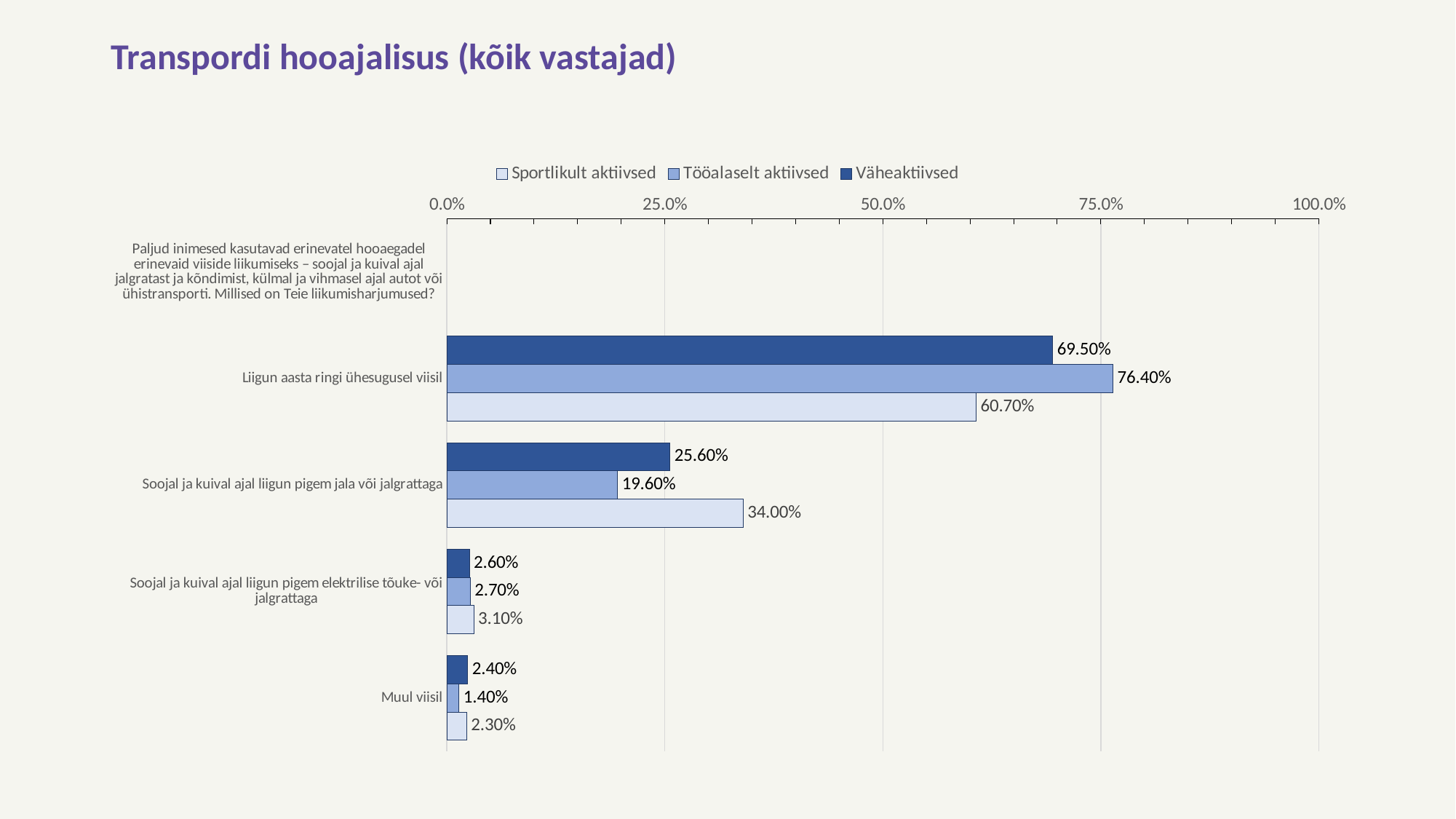
What is the difference between the Tööalaselt aktiivsed and Sportlikult aktiivsed values in the category "Liigun aasta ringi ühesugusel viisil"? 15.70% Is the Väheaktiivsed value for "Liigun aasta ringi ühesugusel viisil" greater or less than 50.0%? greater What is the value for Sportlikult aktiivsed in the category "Soojal ja kuival ajal liigun pigem jala või jalgrattaga"? 34.00% Which series has the lowest value in the category "Soojal ja kuival ajal liigun pigem jala või jalgrattaga"? Tööalaselt aktiivsed What kind of chart is shown on the slide? bar chart What is the title of the slide? Transpordi hooajalisus (kõik vastajad) What is the value for Tööalaselt aktiivsed in the category "Soojal ja kuival ajal liigun pigem elektrilise tõuke- või jalgrattaga"? 2.70% Which series has the highest value in the category "Liigun aasta ringi ühesugusel viisil"? Tööalaselt aktiivsed What is the value for Väheaktiivsed in the category "Muul viisil"? 2.40% What is the value for Tööalaselt aktiivsed in the category "Liigun aasta ringi ühesugusel viisil"? 76.40% How many series does the legend list? 3 In the category "Soojal ja kuival ajal liigun pigem jala või jalgrattaga", which is larger: the Väheaktiivsed value or the Sportlikult aktiivsed value? Sportlikult aktiivsed